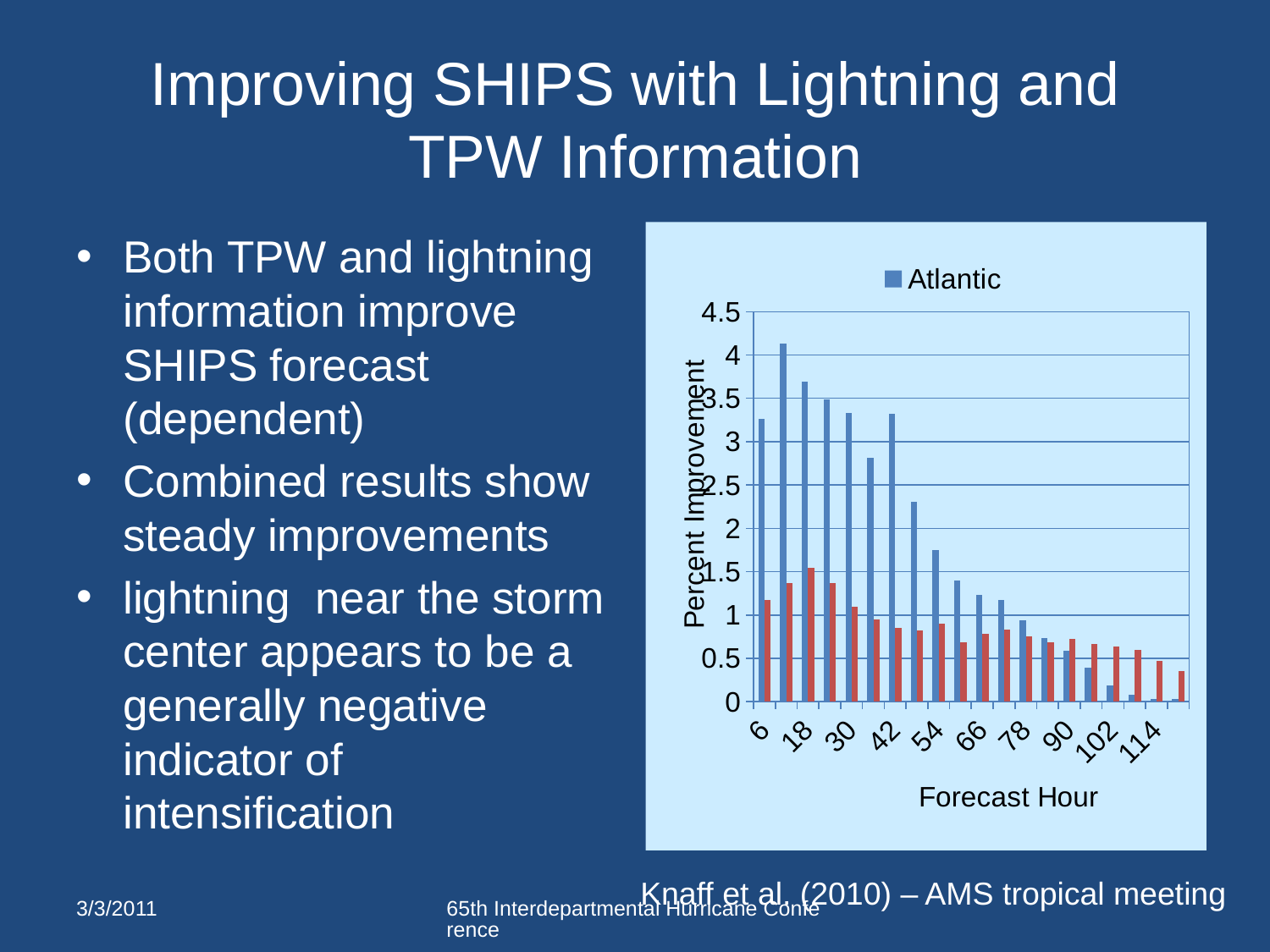
Is the Atlantic value at forecast hour 6 greater or less than 3? greater What is the title of the chart's x axis? Forecast Hour What kind of chart is shown on the slide? bar chart How many forecast hour labels are shown on the x axis? 10 What series name appears in the chart legend? Atlantic Is the Atlantic value at forecast hour 54 greater or less than 2? less Do the Atlantic values generally rise or fall as the forecast hour increases? fall How many series does the chart legend list? 1 Is the Atlantic value at forecast hour 102 greater or less than 0.5? less Which is larger, the Atlantic value at forecast hour 6 or at forecast hour 66? forecast hour 6